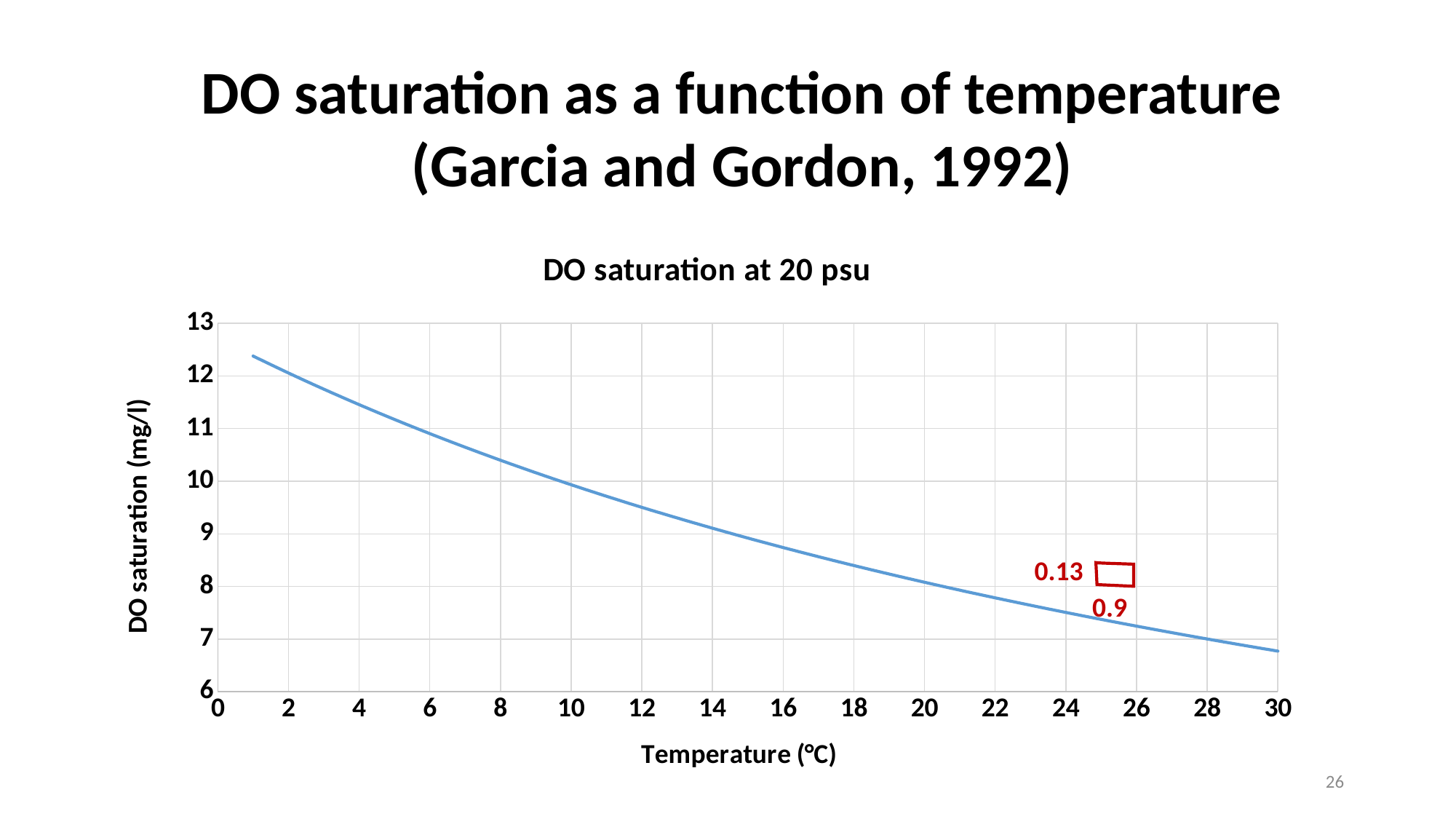
Is the DO saturation at 4 °C greater or less than 11 mg/l? greater What is the title of the chart? DO saturation at 20 psu Is the DO saturation at 30 °C greater or less than 7 mg/l? less Does DO saturation rise or fall as temperature increases along the x axis? fall Which has the larger DO saturation, 10 °C or 20 °C? 10 °C Is the DO saturation at 12 °C greater or less than 10 mg/l? less Is DO saturation highest at the low-temperature end or the high-temperature end of the curve? low-temperature end What kind of chart is shown on the slide? line chart What number is written in red to the left of the small red box on the chart? 0.13